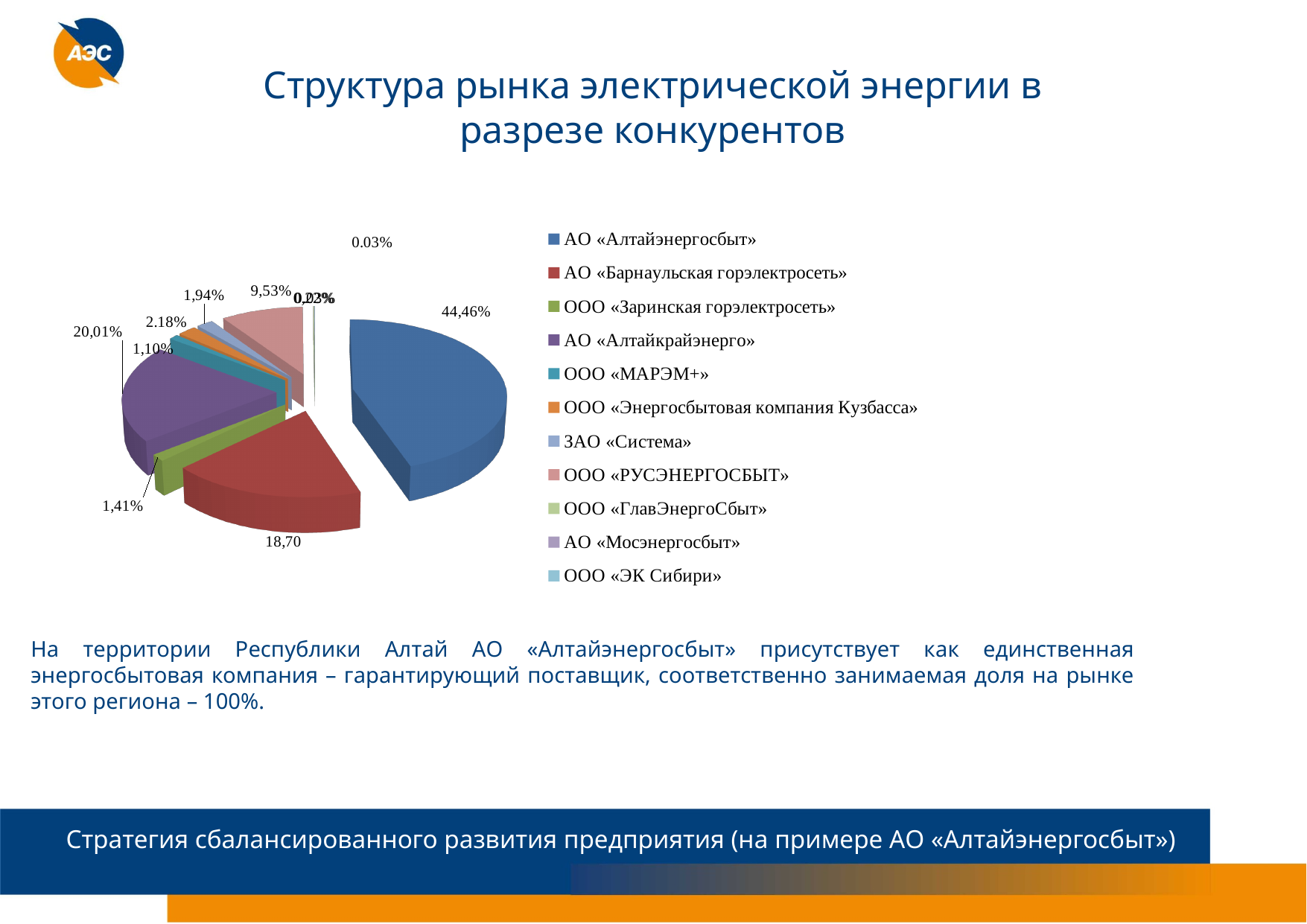
What share is shown for ООО «РУСЭНЕРГОСБЫТ»? 9,53% How many entries does the chart legend list? 11 What type of chart is shown on the slide? pie chart What share is shown for АО «Алтайкрайэнерго»? 20,01% What share of the market does АО «Алтайэнергосбыт» hold according to the chart? 44,46% What share is shown for ООО «Заринская горэлектросеть»? 1,41% What colour is the largest slice of the pie? blue By how many percentage points does the share of АО «Алтайэнергосбыт» exceed that of АО «Алтайкрайэнерго»? 24,45% What value is labelled for АО «Барнаульская горэлектросеть»? 18,70 Which company has the largest slice of the pie? АО «Алтайэнергосбыт» Which has the larger share: АО «Алтайкрайэнерго» or АО «Барнаульская горэлектросеть»? АО «Алтайкрайэнерго» What is the title of the slide containing the chart? Структура рынка электрической энергии в разрезе конкурентов